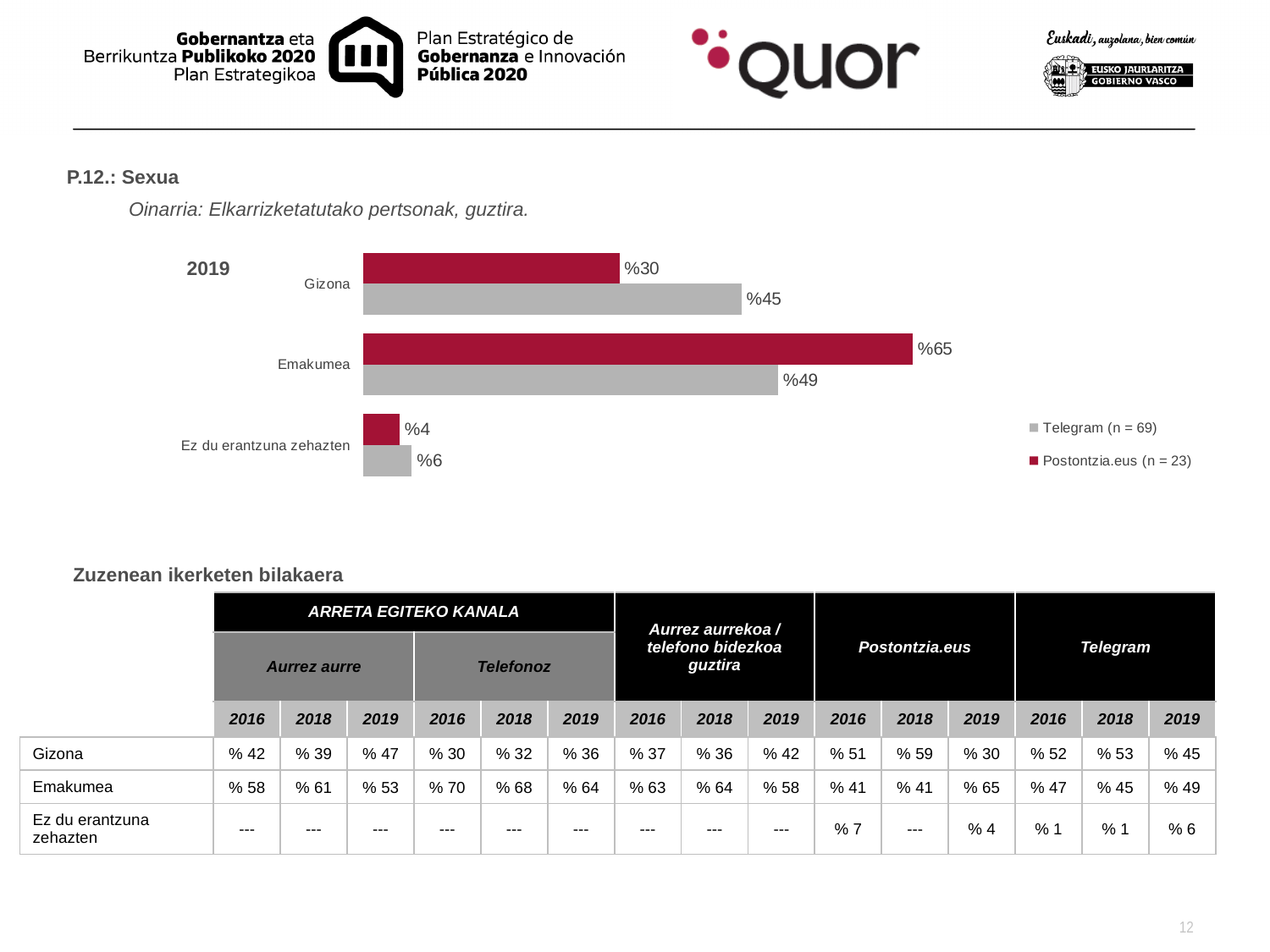
What sample size (n) does the legend give for Postontzia.eus? 23 For Gizona, which series has the larger value in the bar chart, Telegram or Postontzia.eus? Telegram What is the Postontzia.eus value for Gizona in the bar chart? %30 What is the difference between the Postontzia.eus and Telegram values for Emakumea in the bar chart? %16 How many categories are shown in the bar chart? 3 Which category has the highest Postontzia.eus value in the bar chart? Emakumea Which colour represents Telegram in the bar chart? Grey How many series does the legend of the bar chart list? 2 What type of chart is shown on the slide? Bar chart What is the Telegram value for Ez du erantzuna zehazten in the bar chart? %6 What is the Telegram value for Emakumea in the bar chart? %49 Which category has the lowest Telegram value in the bar chart? Ez du erantzuna zehazten